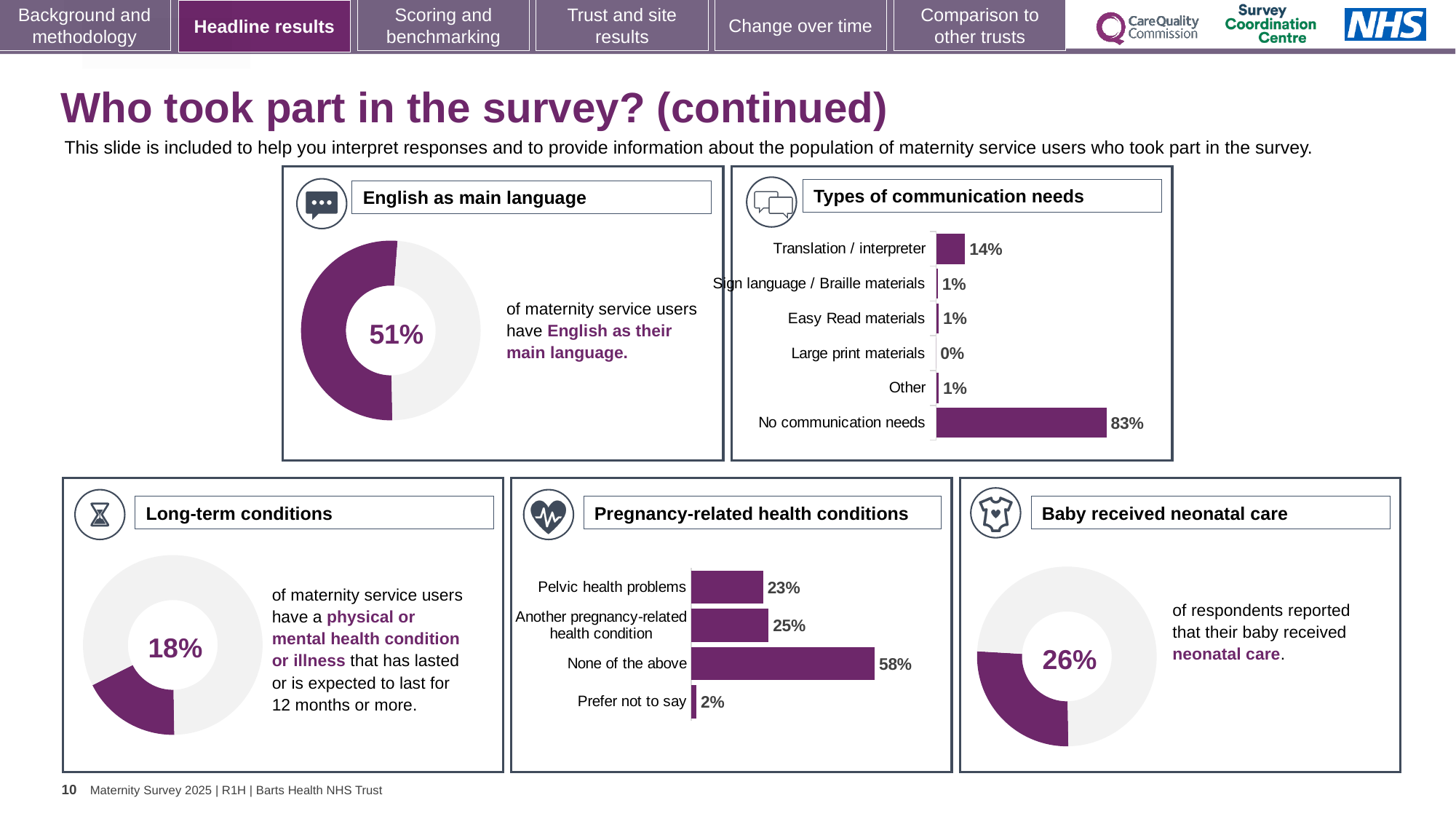
What kind of chart is used in the 'Pregnancy-related health conditions' panel? Bar chart In the 'Pregnancy-related health conditions' chart, which is larger: Pelvic health problems or Another pregnancy-related health condition? Another pregnancy-related health condition In the 'English as main language' donut chart, what percentage of maternity service users have English as their main language? 51% In the 'Types of communication needs' chart, which category has the highest value? No communication needs In the 'Pregnancy-related health conditions' chart, which category has the lowest value? Prefer not to say In the 'Types of communication needs' chart, what is the difference between No communication needs and Translation / interpreter? 69% In the 'Types of communication needs' chart, what percentage is shown for Translation / interpreter? 14% In the 'Long-term conditions' donut chart, what percentage of maternity service users have a physical or mental health condition or illness? 18% In the 'Pregnancy-related health conditions' chart, what percentage is shown for Pelvic health problems? 23% In the 'Types of communication needs' chart, what is the value for Large print materials? 0% In the 'Types of communication needs' chart, how many categories are plotted? 6 In the 'Baby received neonatal care' donut chart, what percentage of respondents reported that their baby received neonatal care? 26%